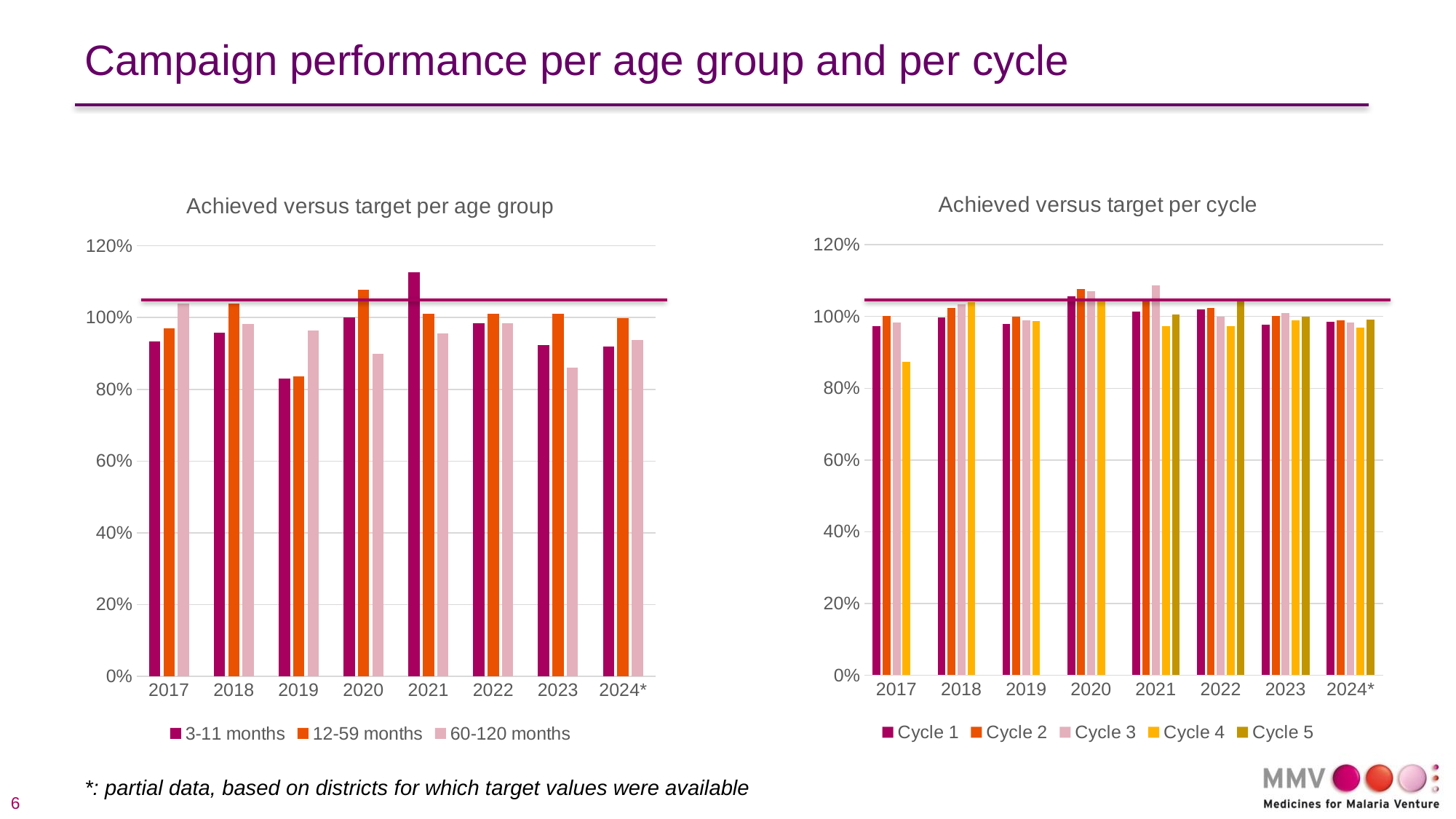
In the left chart, 'Achieved versus target per age group', which year has the highest bar for 12-59 months? 2020 In the left chart, 'Achieved versus target per age group', is the value for 3-11 months in 2019 greater or less than 100%? less In the left chart, 'Achieved versus target per age group', which year has the lowest bar for 60-120 months? 2023 In the left chart, 'Achieved versus target per age group', is the value for 3-11 months in 2021 greater or less than 100%? greater How many series does the legend of the left chart, 'Achieved versus target per age group', list? 3 In the left chart, 'Achieved versus target per age group', which year has the highest bar for 3-11 months? 2021 What kind of chart is the left chart, 'Achieved versus target per age group'? bar chart How many years are shown on the x axis of the right chart, 'Achieved versus target per cycle'? 8 In the right chart, 'Achieved versus target per cycle', which cycle has the lowest bar in 2017? Cycle 4 How many series does the legend of the right chart, 'Achieved versus target per cycle', list? 5 In the left chart, 'Achieved versus target per age group', which is larger in 2020: 12-59 months or 60-120 months? 12-59 months What is the title of the right chart on the slide? Achieved versus target per cycle